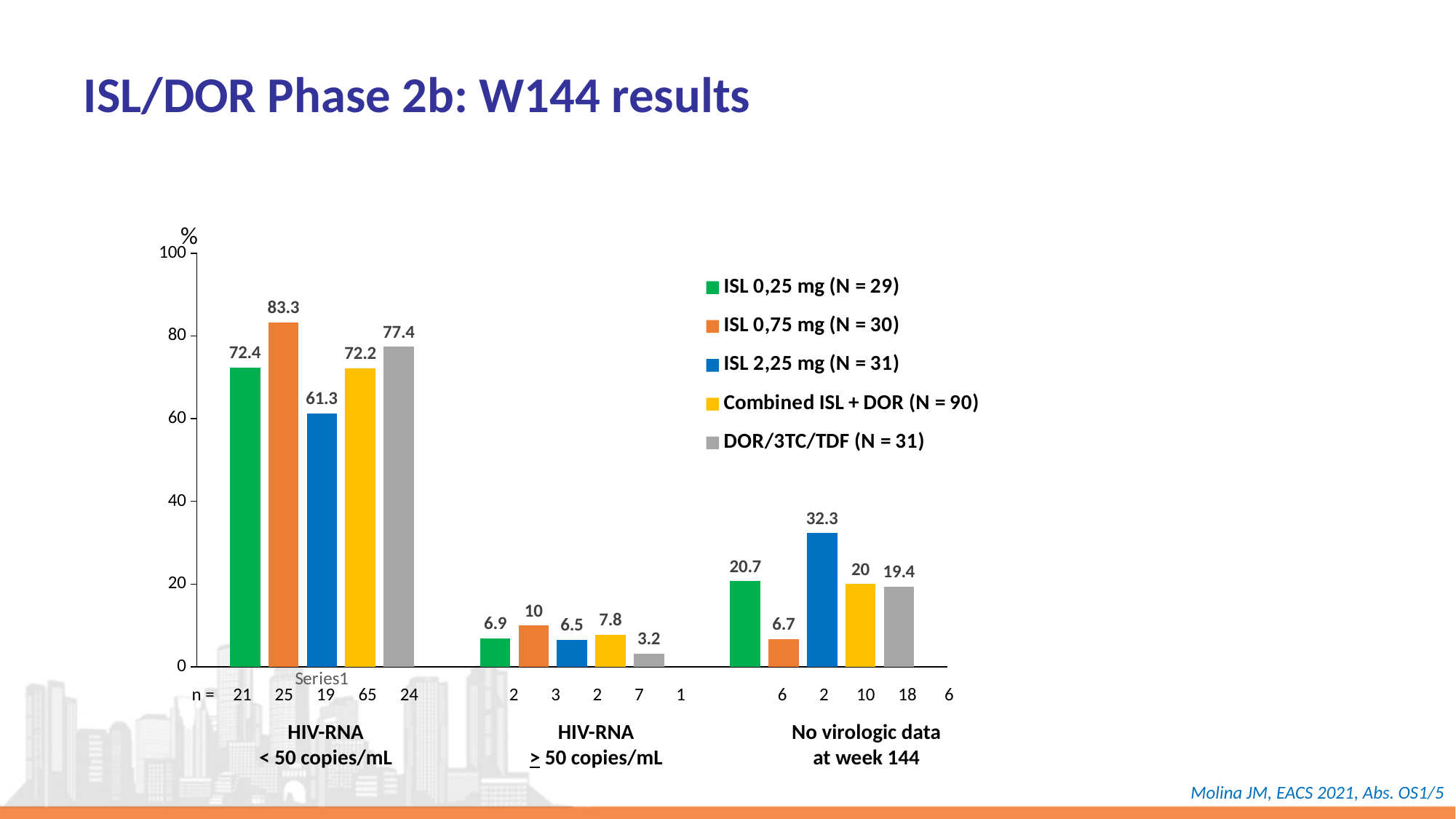
Which series has the lowest value in the HIV-RNA < 50 copies/mL group? ISL 2,25 mg (N = 31) Which is larger in the HIV-RNA ≥ 50 copies/mL group: the value for ISL 0,75 mg or the value for Combined ISL + DOR? ISL 0,75 mg How many series does the legend list? 5 What is the value for ISL 0,75 mg (N = 30) in the HIV-RNA < 50 copies/mL group? 83.3 What is the value for ISL 2,25 mg (N = 31) in the No virologic data at week 144 group? 32.3 Which series has the highest value in the HIV-RNA < 50 copies/mL group? ISL 0,75 mg (N = 30) What colour represents Combined ISL + DOR (N = 90) in the chart? Yellow What is the difference between the ISL 0,75 mg and ISL 2,25 mg values in the HIV-RNA < 50 copies/mL group? 22 What is the value for DOR/3TC/TDF (N = 31) in the HIV-RNA ≥ 50 copies/mL group? 3.2 Is the value for DOR/3TC/TDF in the HIV-RNA < 50 copies/mL group greater or less than 60? greater Which series has the lowest value in the No virologic data at week 144 group? ISL 0,75 mg (N = 30) What kind of chart is shown on the slide? Bar chart